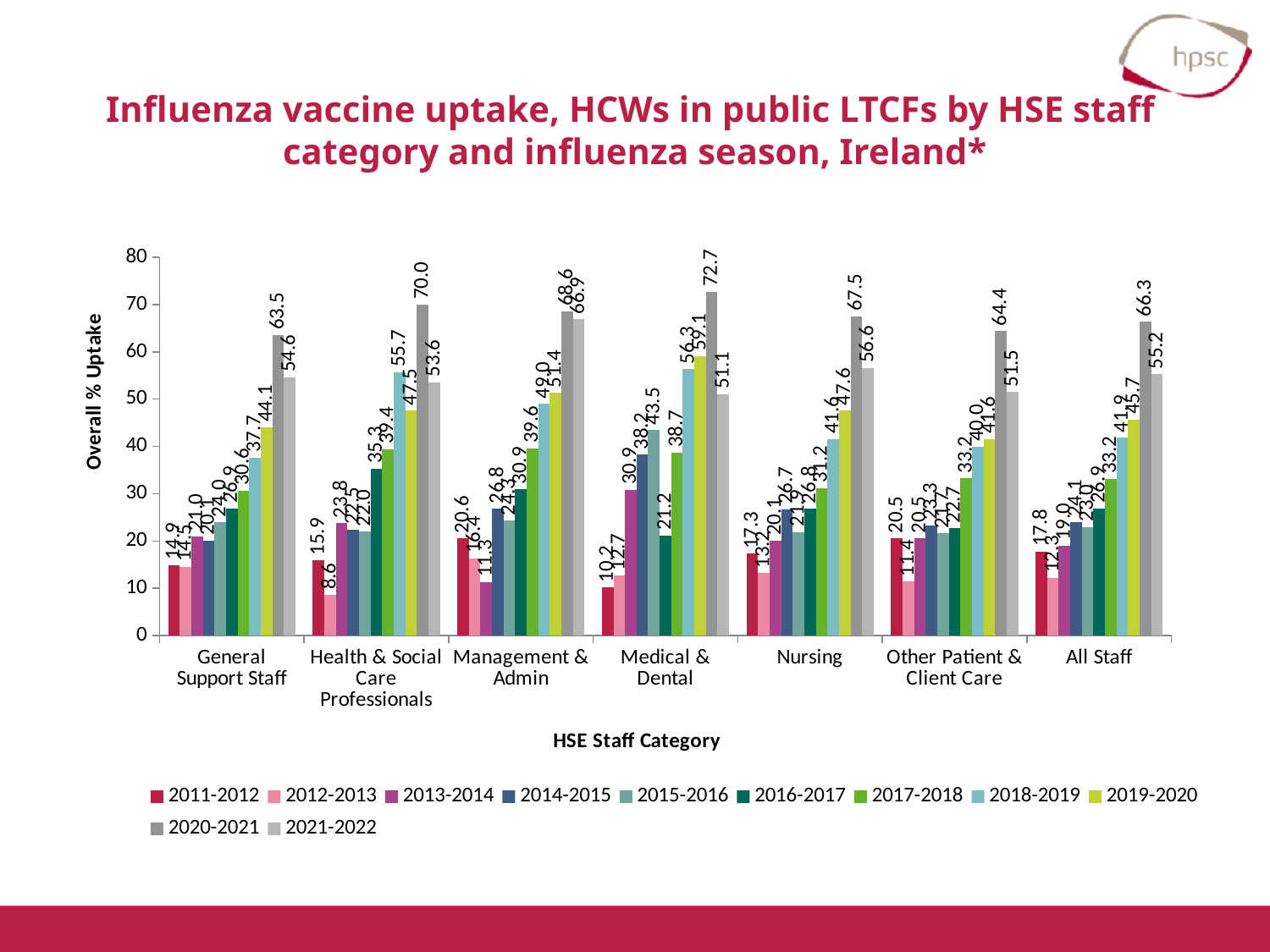
What kind of chart is shown on the slide? Bar chart What is the difference between the All Staff values for 2020-2021 and 2021-2022? 11.1 What is the value for Nursing in the 2021-2022 season? 56.6 What is the value for Medical & Dental in the 2020-2021 season? 72.7 How many HSE staff categories are shown on the x axis? 7 Which HSE staff category has the highest value in the 2020-2021 season? Medical & Dental Which HSE staff category has the lowest value in the 2020-2021 season? General Support Staff Which is larger in the 2020-2021 season: Health & Social Care Professionals or Management & Admin? Health & Social Care Professionals What is the value for All Staff in the 2020-2021 season? 66.3 What is the title of the y axis? Overall % Uptake What is the value for Health & Social Care Professionals in the 2012-2013 season? 8.6 How many influenza seasons does the legend list? 11